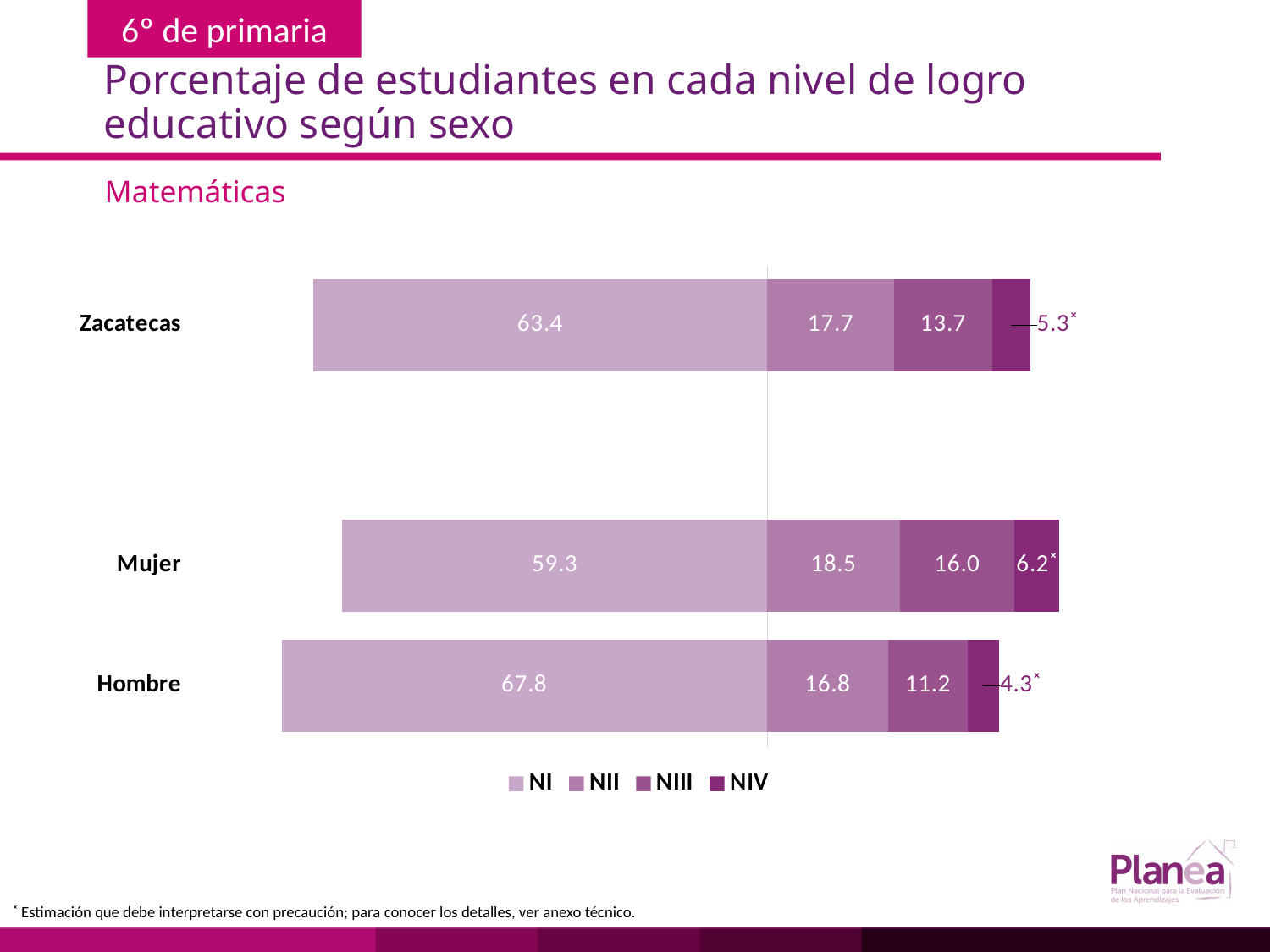
What is the total of the stacked bar for Mujer? 100.0 How many series does the legend list? 4 What type of chart is shown on the slide? Stacked bar chart What is the NIV value for Zacatecas? 5.3 What is the difference between the NI values for Hombre and Mujer? 8.5 Which category has the highest NI value? Hombre Which category has the lowest NIV value? Hombre Which is larger, the NIII value for Mujer or the NIII value for Hombre? Mujer What is the NIII value for Mujer? 16.0 What is the NII value for Zacatecas? 17.7 What is the NI value for Hombre? 67.8 How many categories are shown on the chart? 3